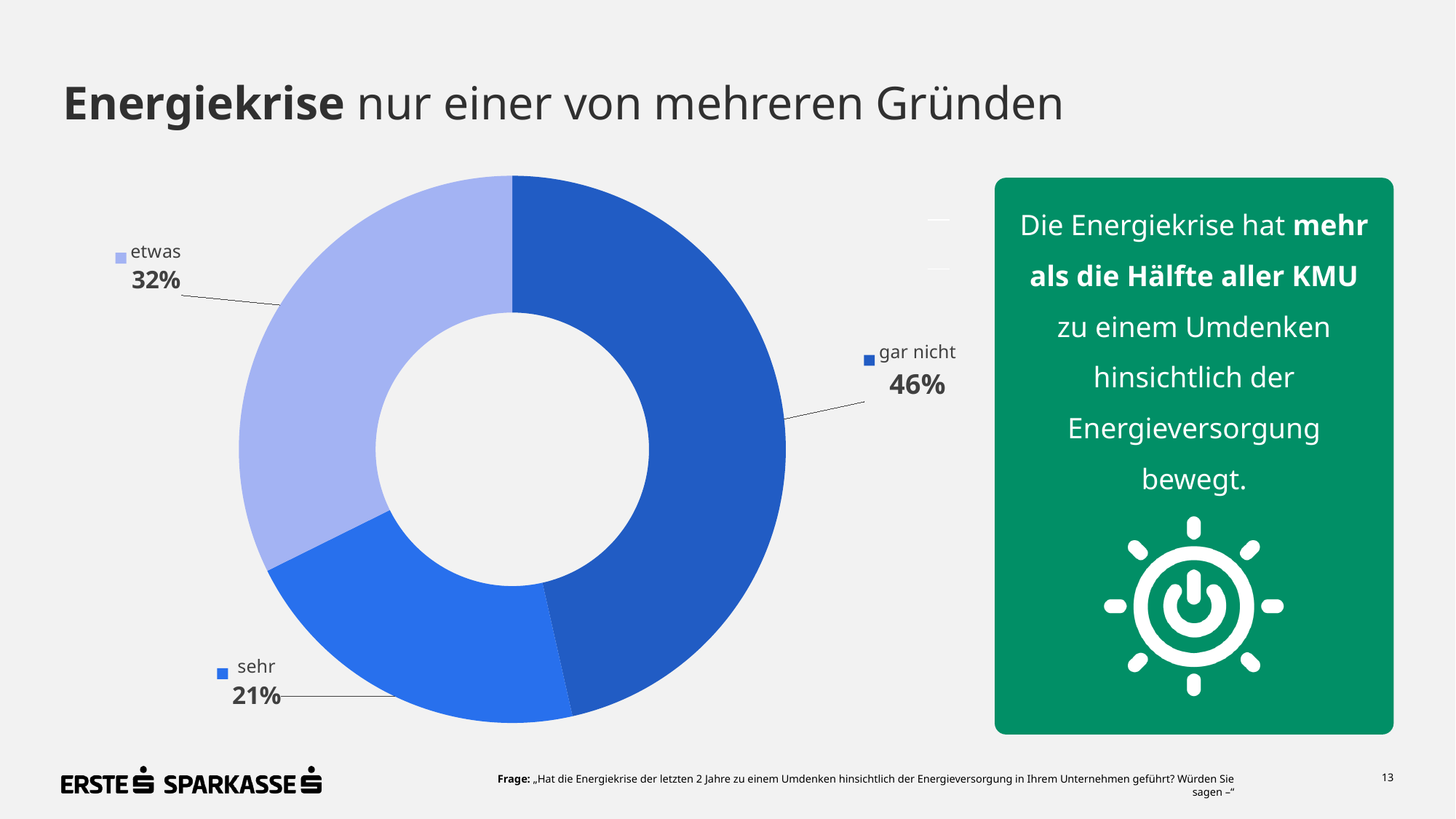
Which category is shown in the lightest blue colour? etwas What is the combined share of "etwas" and "sehr"? 53% What kind of chart is shown on the slide? doughnut chart What percentage of the pie chart is labelled "sehr"? 21% What percentage of the pie chart is labelled "etwas"? 32% Which category has the smallest share of the pie chart? sehr How many categories does the pie chart show? 3 What is the difference in percentage points between "gar nicht" and "sehr"? 25 Which category has the largest share of the pie chart? gar nicht What is the difference in percentage points between "etwas" and "sehr"? 11 What percentage of the pie chart is labelled "gar nicht"? 46% Which is larger, the share for "etwas" or the share for "sehr"? etwas